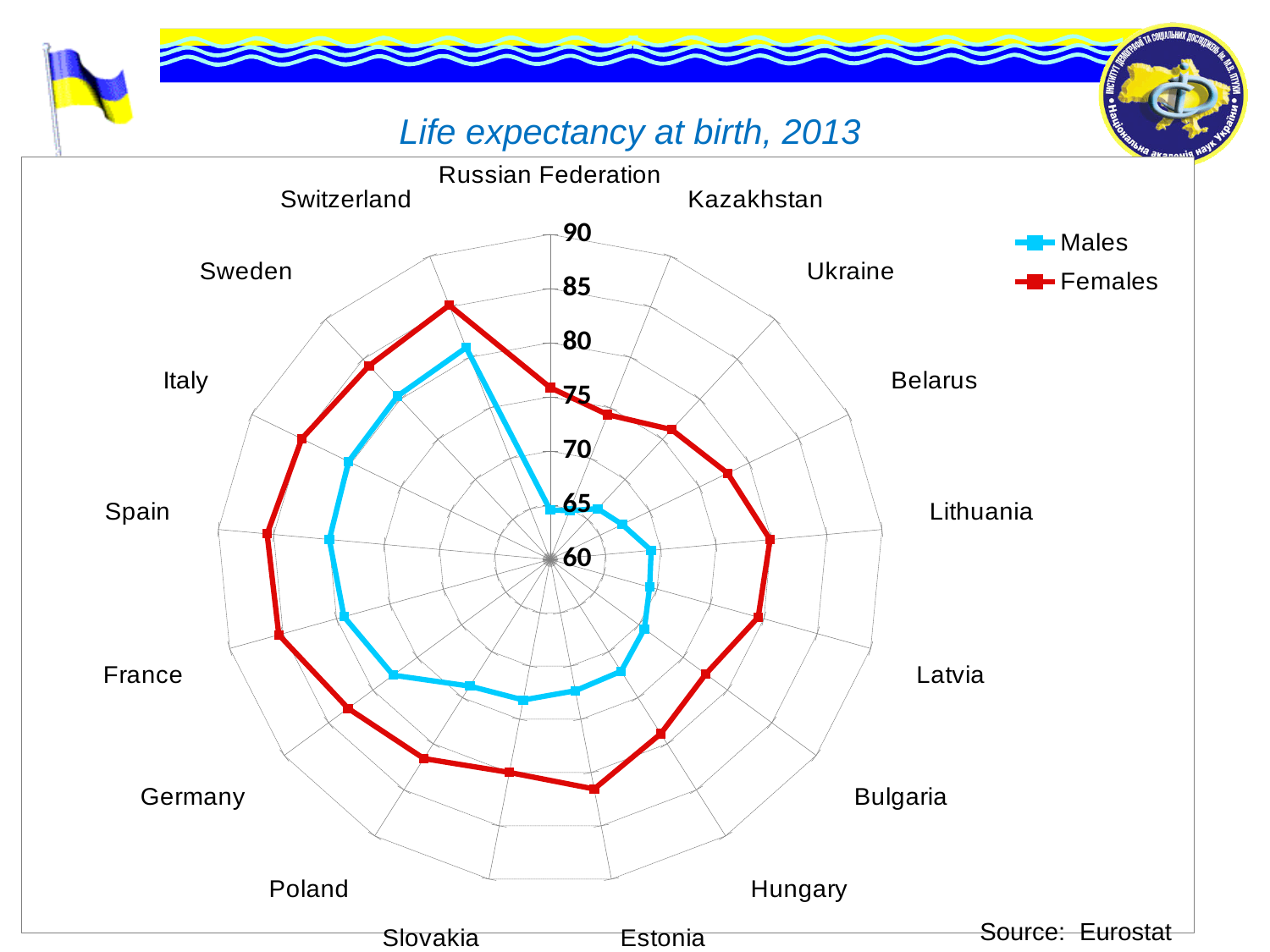
What is the title of the chart? Life expectancy at birth, 2013 How many series does the legend list? 2 How many countries are plotted on the chart? 17 Which colour represents the Females series? red What kind of chart is shown on the slide? radar chart Is the Males value for Poland greater or less than 75? less Is the Males value for Germany greater or less than 80? less Which is larger, the Females value for Spain or the Females value for Ukraine? Spain Is the Females value for Hungary greater or less than 75? greater Which is larger, the Males value for Switzerland or the Males value for the Russian Federation? Switzerland